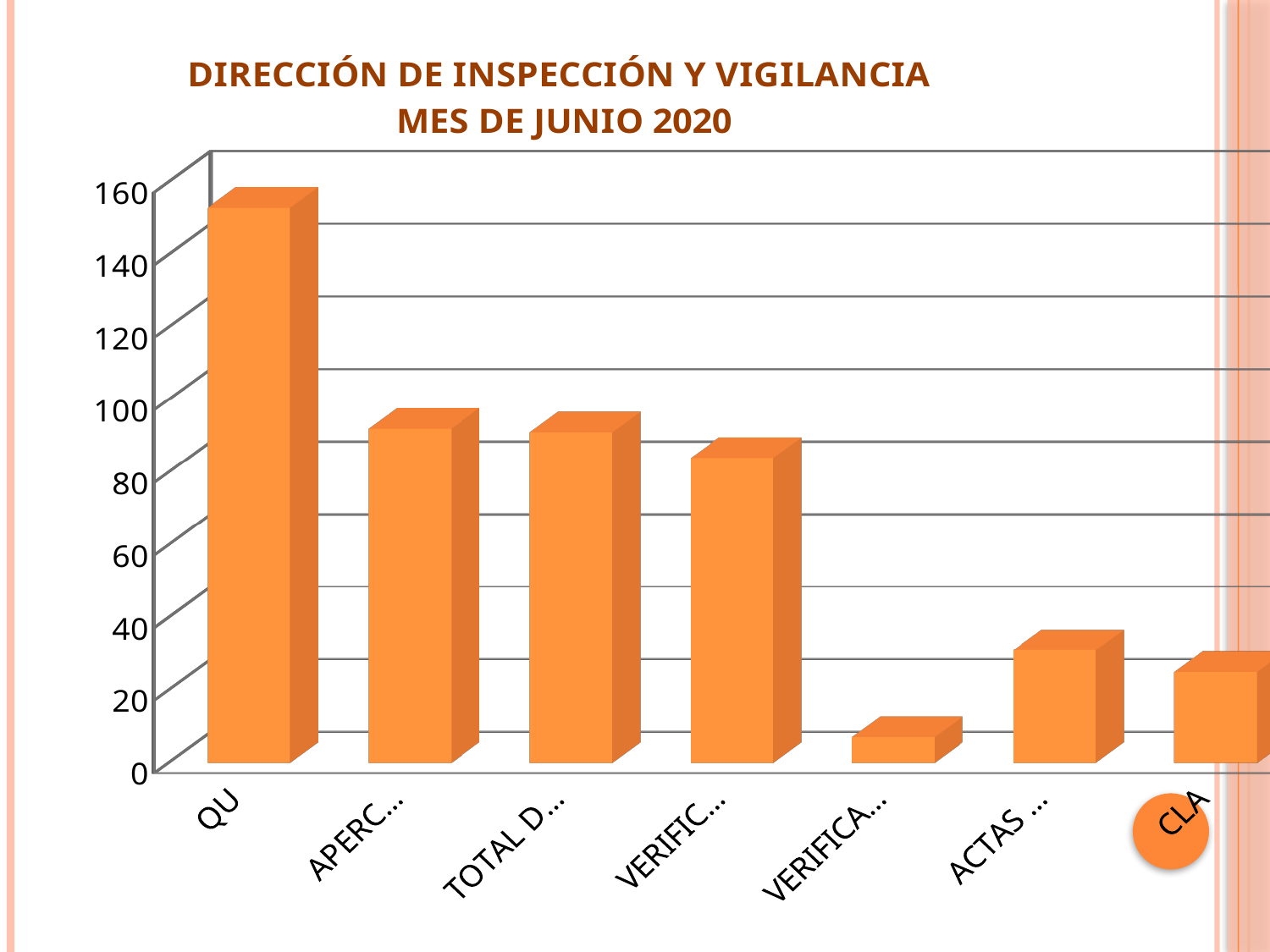
Which is larger, the value for QU or the value for APERC...? QU Which category has the highest bar? QU (the first bar) What colour are the bars in the chart? Orange What is the title of the chart? DIRECCIÓN DE INSPECCIÓN Y VIGILANCIA MES DE JUNIO 2020 Which category has the lowest bar? VERIFICA... (the fifth bar) Which is larger, the value for ACTAS ... or the value for CLA? ACTAS ... Is the value for APERC... greater or less than 100? less Is the value for QU greater or less than 140? greater What kind of chart is shown on the slide? Bar chart How many bars does the chart contain? 7 Is the value for VERIFICA... greater or less than 20? less